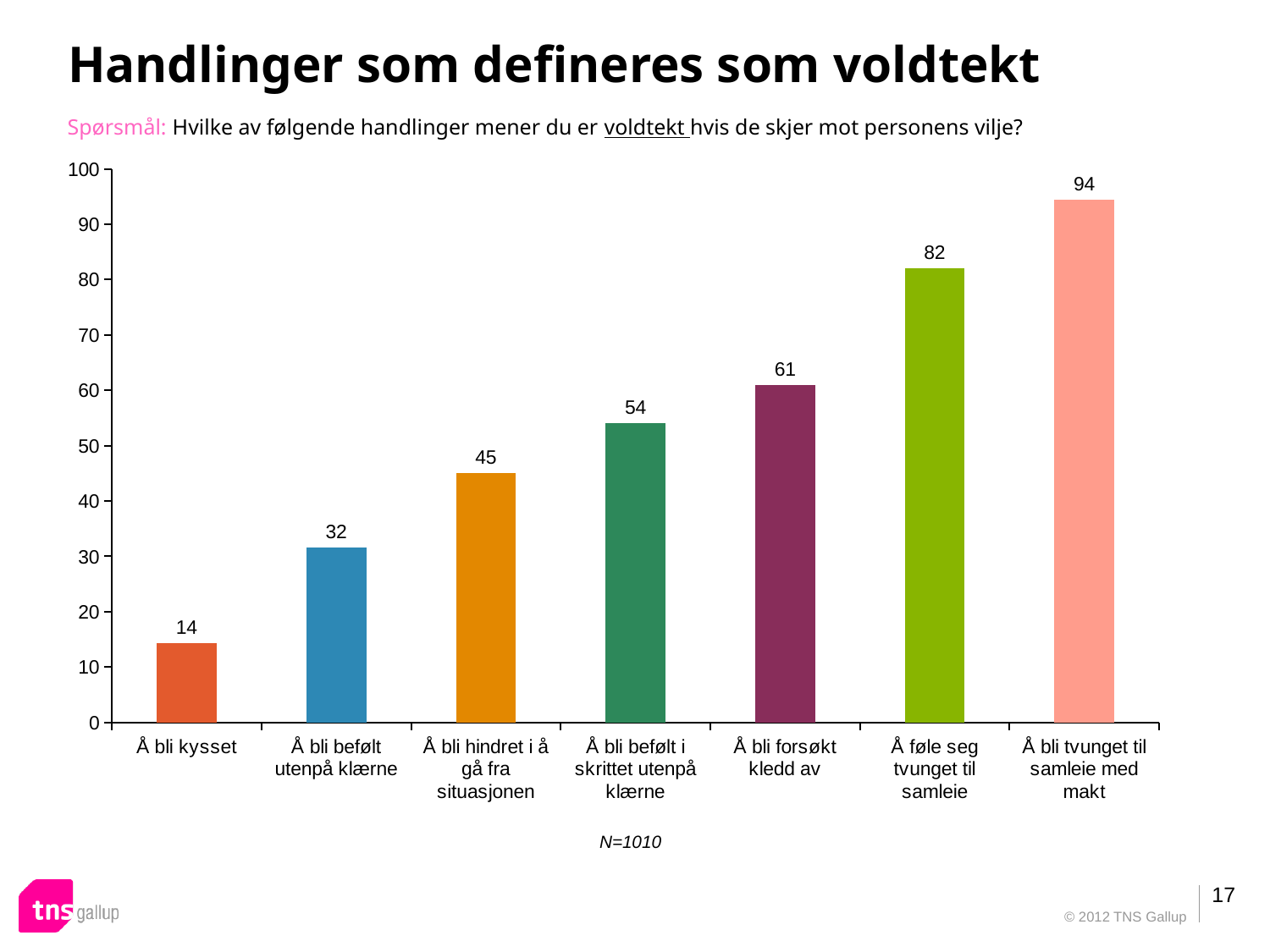
Do the values rise or fall from left to right along the x axis? Rise What is the value for "Å bli kysset"? 14 What is the value for "Å bli forsøkt kledd av"? 61 What sample size (N) is stated below the chart? N=1010 How many categories are shown in the chart? 7 What is the difference between the values for "Å bli befølt i skrittet utenpå klærne" and "Å bli befølt utenpå klærne"? 22 Which is larger: the value for "Å bli hindret i å gå fra situasjonen" or the value for "Å bli befølt utenpå klærne"? Å bli hindret i å gå fra situasjonen Which category has the highest value? Å bli tvunget til samleie med makt What kind of chart is shown on the slide? Bar chart Which category has the lowest value? Å bli kysset What is the difference between the values for "Å bli tvunget til samleie med makt" and "Å føle seg tvunget til samleie"? 12 What is the value for "Å føle seg tvunget til samleie"? 82